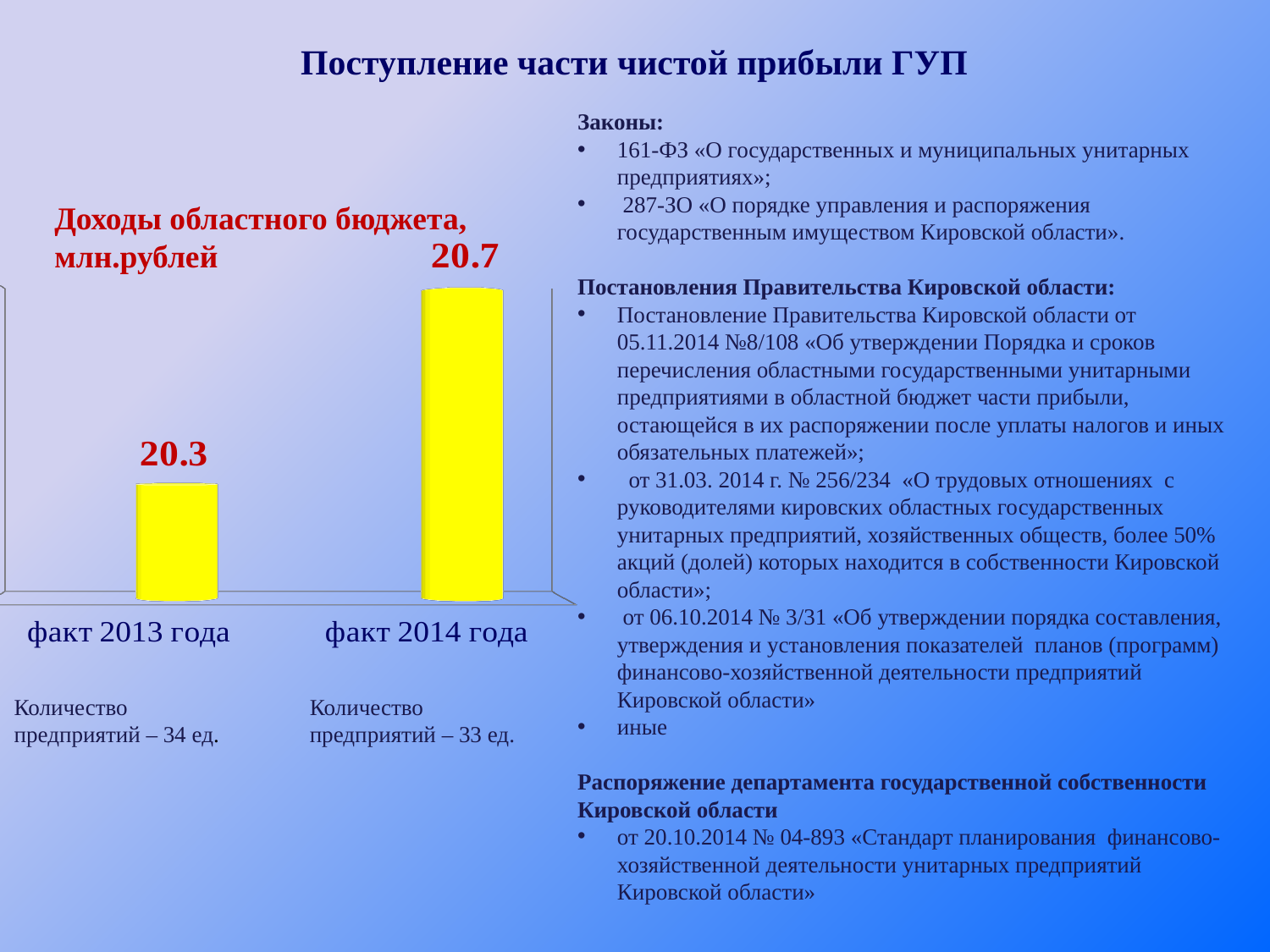
Which category has the lowest value? факт 2013 года What is the value for факт 2014 года? 20.7 What is the title of the chart? Доходы областного бюджета, млн.рублей Which category has the highest value? факт 2014 года What colour are the bars in the chart? yellow What is the value for факт 2013 года? 20.3 How many categories are shown in the chart? 2 What is the difference between the values for факт 2014 года and факт 2013 года? 0.4 Do the values rise or fall from факт 2013 года to факт 2014 года? rise Which is larger, the value for факт 2013 года or факт 2014 года? факт 2014 года What kind of chart is shown on the slide? bar chart